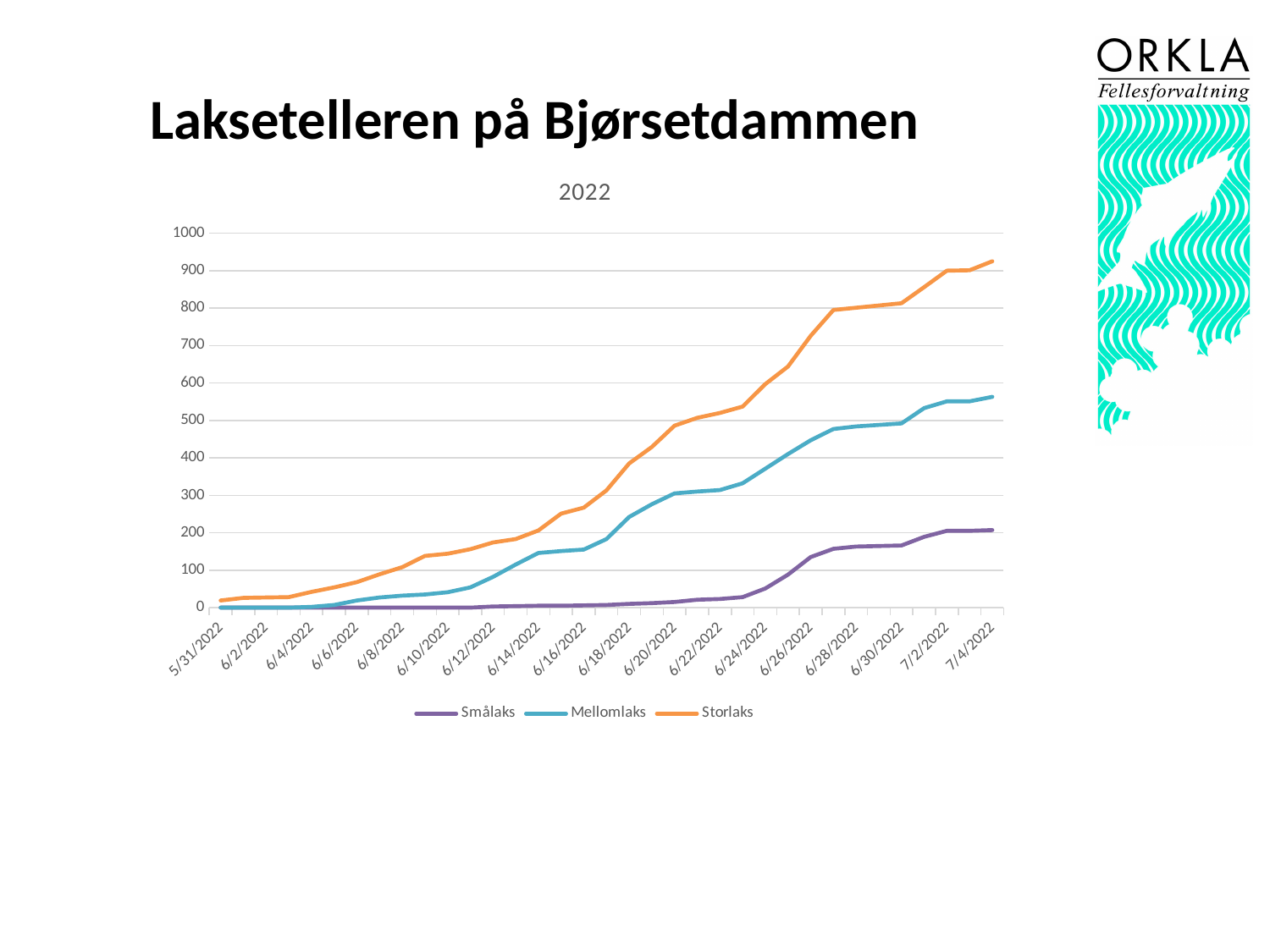
How many series does the legend list? 3 Which series has the lowest value at 7/4/2022? Smålaks Is the value for Mellomlaks at 7/4/2022 greater or less than 600? less Is the value for Storlaks at 7/4/2022 greater or less than 900? greater What kind of chart is shown on the slide? line chart Which series has the highest value at 7/4/2022? Storlaks What are the series names listed in the legend? Smålaks, Mellomlaks, Storlaks Is the value for Storlaks at 6/28/2022 greater or less than 700? greater Do the values for Storlaks rise or fall from 5/31/2022 to 7/4/2022? rise What is the title shown above the chart? 2022 At 6/20/2022, which is larger: Storlaks or Mellomlaks? Storlaks